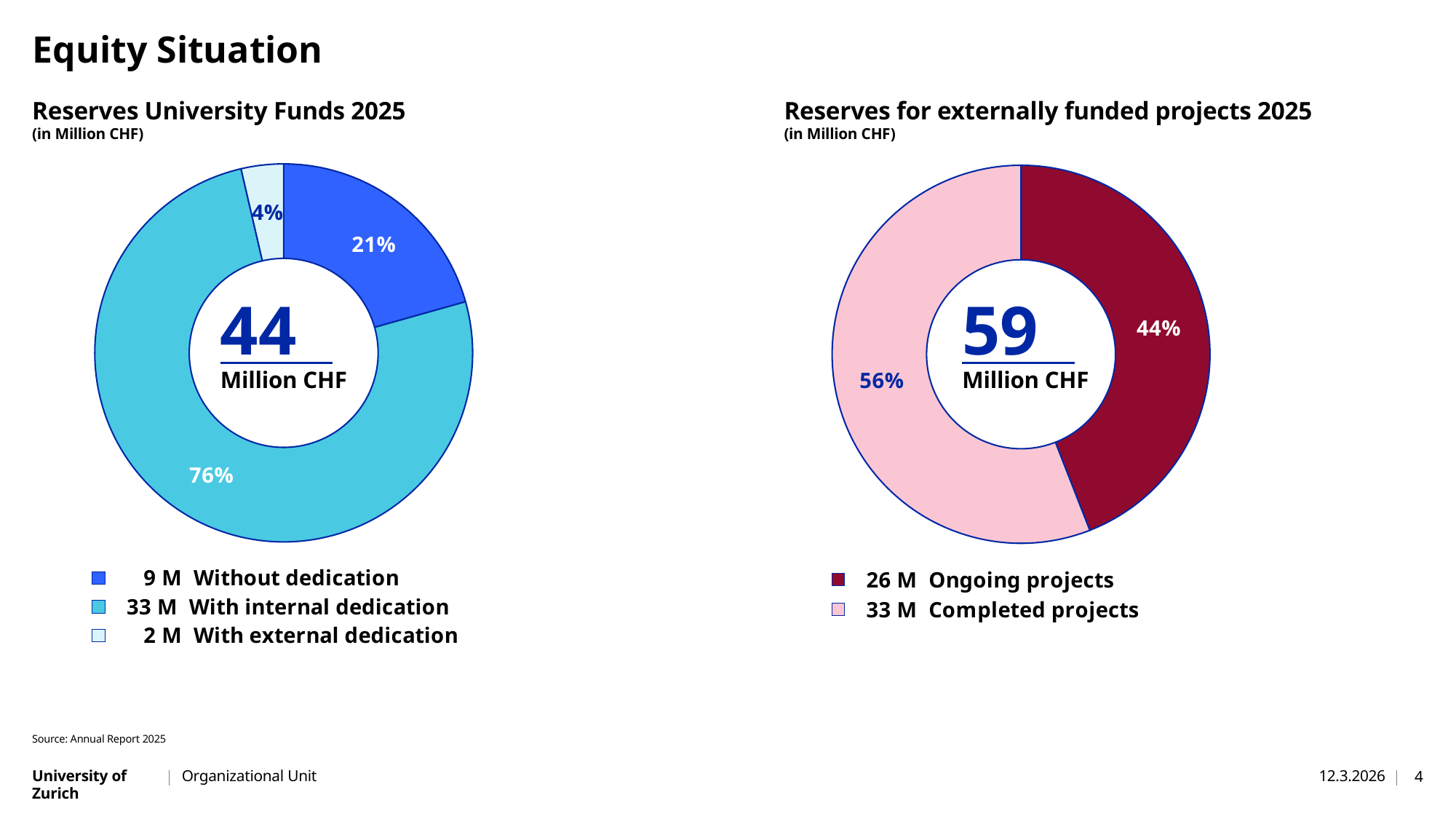
In the 'Reserves University Funds 2025' chart, what total is shown in the centre of the donut? 44 Million CHF In the 'Reserves University Funds 2025' chart, which category has the smallest share? With external dedication In the 'Reserves for externally funded projects 2025' chart, what value does the legend give for 'Completed projects'? 33 M In the 'Reserves University Funds 2025' chart, which category has the largest share? With internal dedication In the 'Reserves for externally funded projects 2025' chart, what percentage share is labelled for 'Ongoing projects'? 44% In the 'Reserves for externally funded projects 2025' chart, what is the difference in million CHF between 'Completed projects' and 'Ongoing projects'? 7 M How many categories does the 'Reserves University Funds 2025' chart show? 3 What kind of chart is used for 'Reserves for externally funded projects 2025'? Donut (pie) chart In the 'Reserves University Funds 2025' chart, what percentage share is labelled for 'With internal dedication'? 76% In the 'Reserves University Funds 2025' chart, what value does the legend give for 'Without dedication'? 9 M In the 'Reserves for externally funded projects 2025' chart, what total is shown in the centre of the donut? 59 Million CHF In the 'Reserves for externally funded projects 2025' chart, which is larger, 'Ongoing projects' or 'Completed projects'? Completed projects